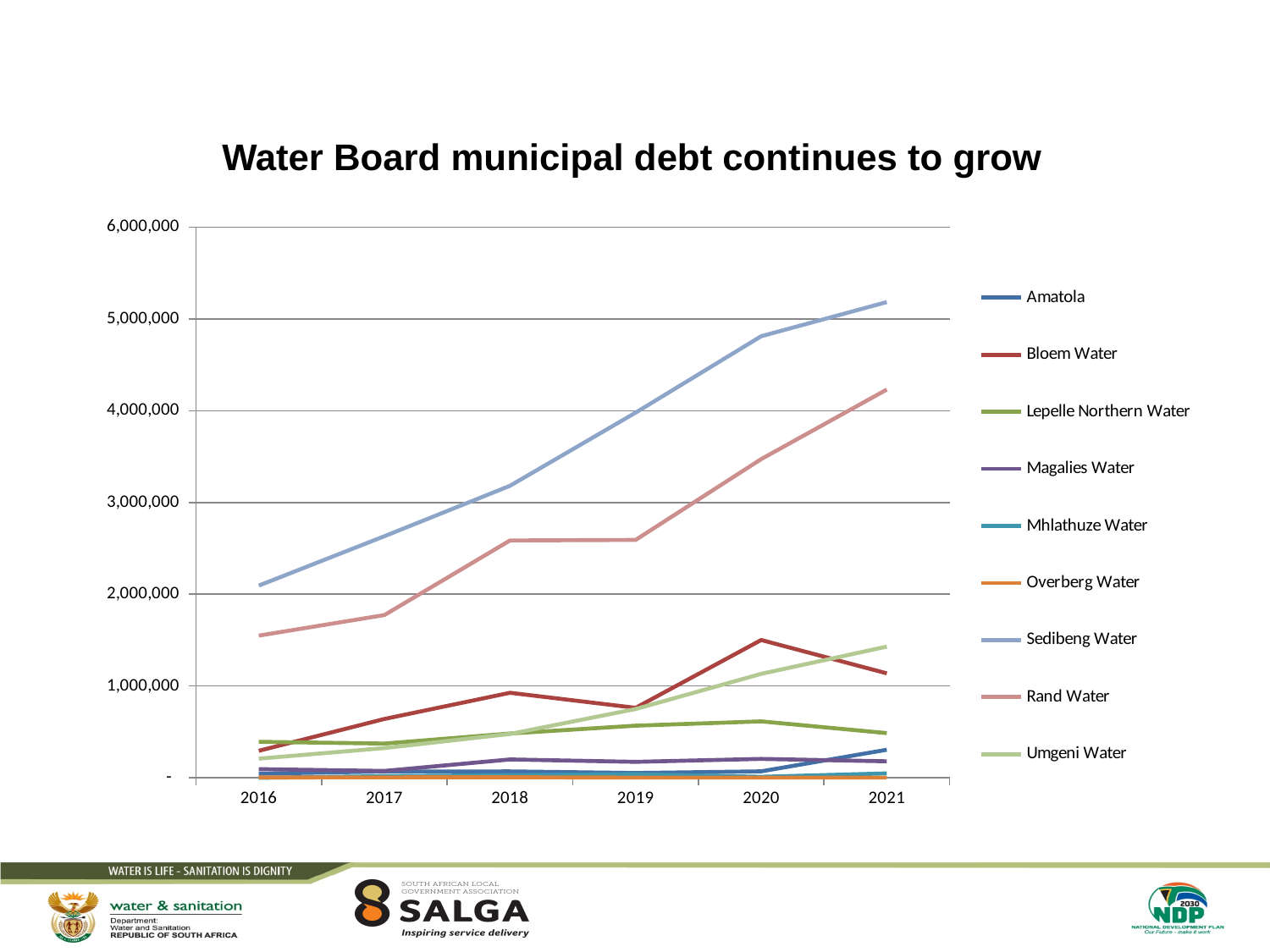
Does the value for Sedibeng Water rise or fall from 2016 to 2021? rise Which is larger in 2021, Sedibeng Water or Rand Water? Sedibeng Water Is the value for Bloem Water in 2020 greater or less than 1,000,000? greater Which is larger in 2021, Umgeni Water or Lepelle Northern Water? Umgeni Water What kind of chart is shown on the slide? line chart Is the value for Rand Water in 2016 greater or less than 2,000,000? less How many series does the legend list? 9 How many years are shown along the x axis? 6 Is the value for Rand Water in 2021 greater or less than 4,000,000? greater What is the title of the chart? Water Board municipal debt continues to grow Which water board has the highest value in 2021? Sedibeng Water